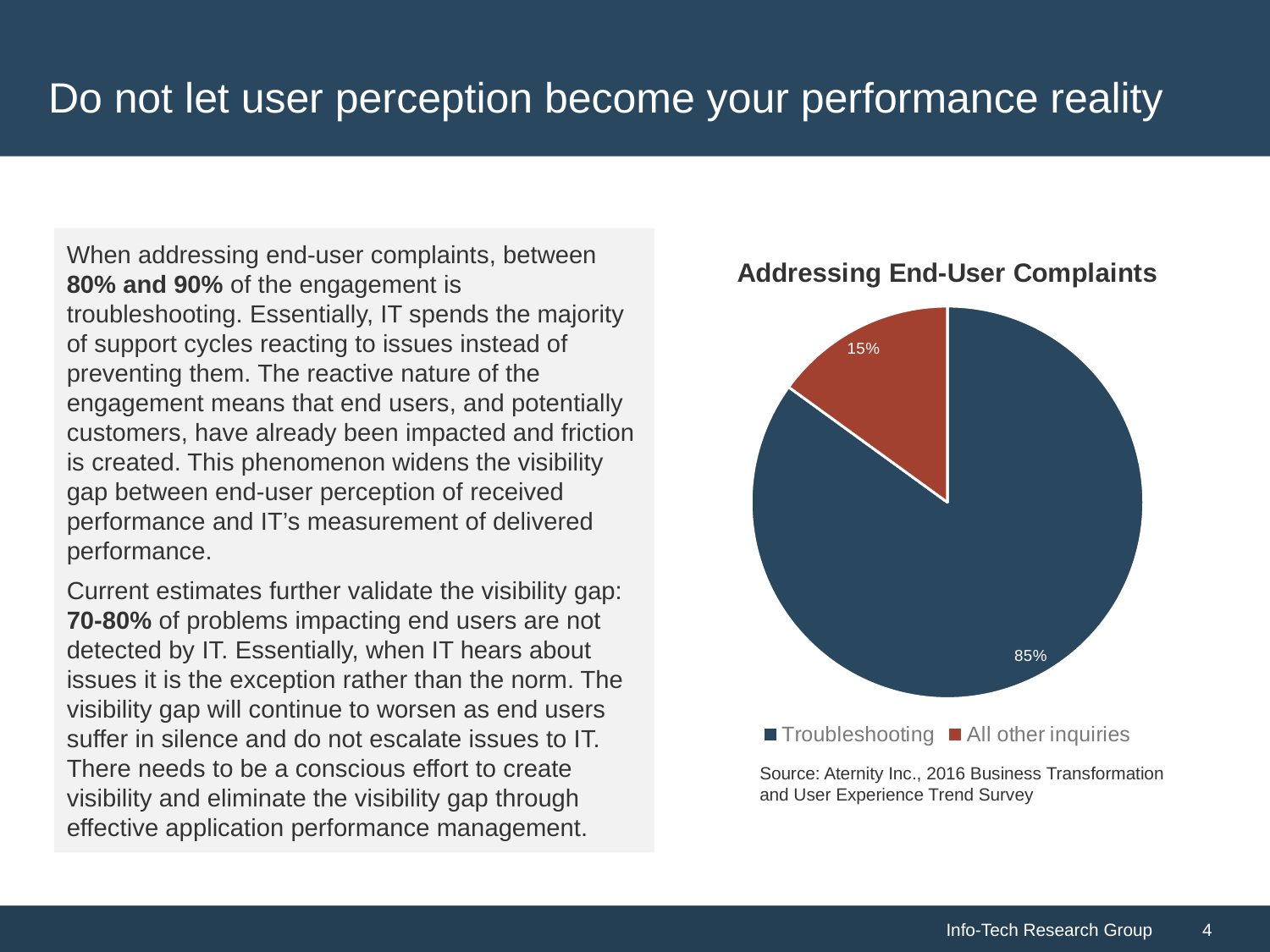
What kind of chart is shown on the slide? Pie chart What share of the pie does All other inquiries account for? 15% How many entries does the legend list? 2 What is the total of the two slices shown in the pie chart? 100% What colour is the Troubleshooting slice? Dark blue Which slice of the pie is the largest? Troubleshooting Which slice of the pie is the smallest? All other inquiries What is the title of the chart? Addressing End-User Complaints Which is larger, the Troubleshooting slice or the All other inquiries slice? Troubleshooting What is the difference in percentage points between the Troubleshooting slice and the All other inquiries slice? 70 What share of the pie does Troubleshooting account for? 85% How many slices does the pie chart have? 2